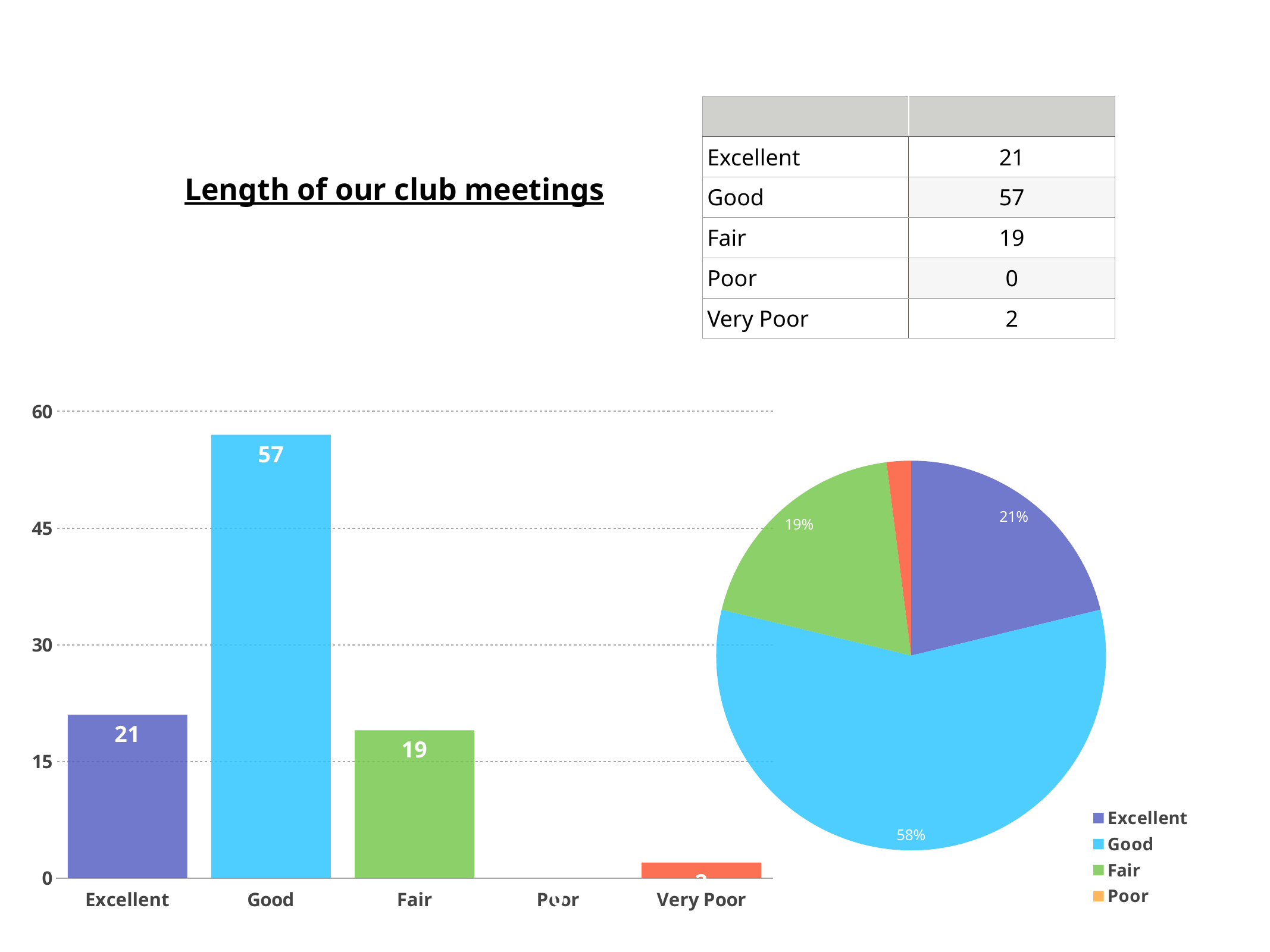
In the pie chart on the right, what share does the Excellent slice have? 21% In the bar chart on the left, what is the difference between the values for Excellent and Fair? 2 In the pie chart on the right, what share does the Good slice have? 58% How many entries does the legend of the pie chart on the right list? 4 How many categories are shown on the x axis of the bar chart on the left? 5 In the bar chart on the left, what is the difference between the values for Good and Excellent? 36 In the bar chart on the left, which is larger, the value for Excellent or the value for Fair? Excellent What kind of chart is the chart on the left of the slide? bar chart In the bar chart on the left, which category has the lowest value? Poor In the bar chart on the left, which category has the highest value? Good In the bar chart on the left, what is the value for Good? 57 In the bar chart on the left, what is the value for Fair? 19